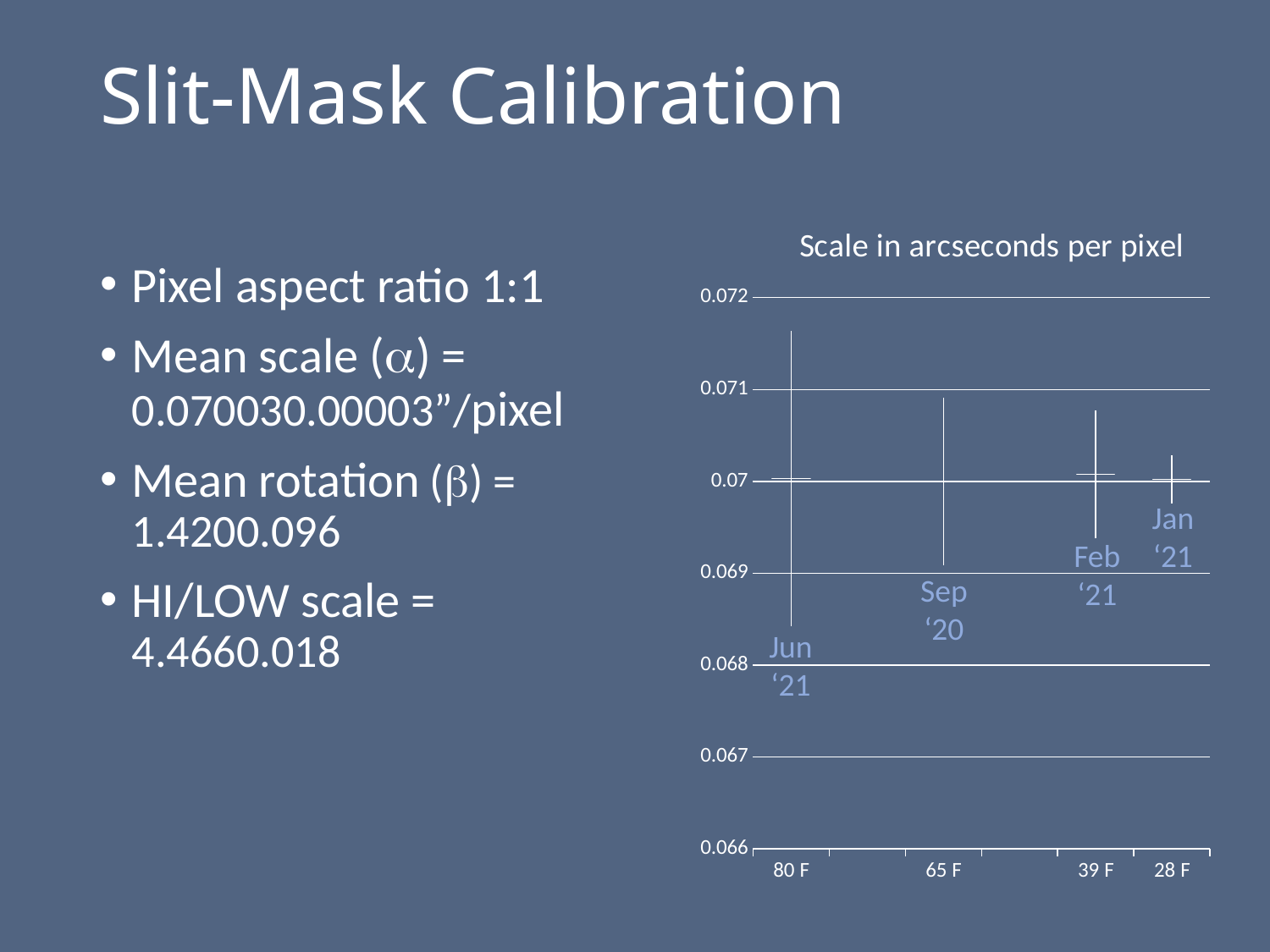
What is the title of the chart on the slide? Scale in arcseconds per pixel What are the x-axis labels of the chart, from left to right? 80 F, 65 F, 39 F, 28 F Is the value for 80 F greater or less than 0.071? less Which date annotation is attached to the data point at 65 F? Sep '20 Is the value for 28 F greater or less than 0.068? greater Is the value for 65 F greater or less than 0.069? greater What is the highest value shown on the y-axis of the chart? 0.072 Which date annotation is attached to the data point at 80 F? Jun '21 How many data points are plotted in the chart? 4